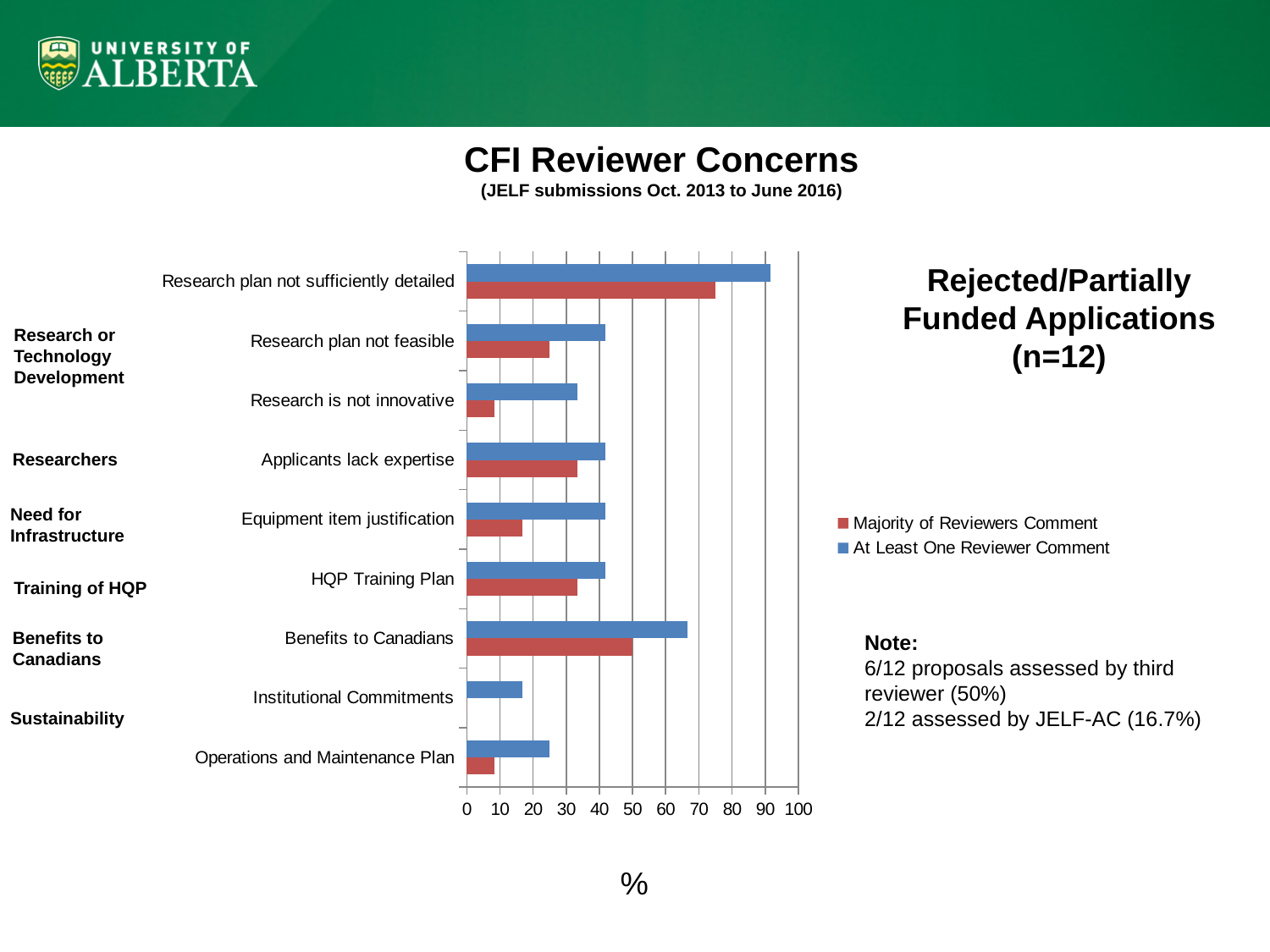
Is the 'At Least One Reviewer Comment' value for 'Research plan not sufficiently detailed' greater or less than 80? greater Which is larger for 'At Least One Reviewer Comment': 'Benefits to Canadians' or 'HQP Training Plan'? Benefits to Canadians Which concern has the lowest value for 'At Least One Reviewer Comment'? Institutional Commitments Is the 'Majority of Reviewers Comment' value for 'Research plan not sufficiently detailed' greater or less than 80? less How many concern categories are plotted on the chart? 9 What kind of chart is shown on the slide? bar chart Is the 'At Least One Reviewer Comment' value for 'Operations and Maintenance Plan' greater or less than 30? less How many series does the chart legend list? 2 Which concern has the highest value for 'At Least One Reviewer Comment'? Research plan not sufficiently detailed Which is larger for 'Majority of Reviewers Comment': 'Applicants lack expertise' or 'Research is not innovative'? Applicants lack expertise What is the title of the chart? CFI Reviewer Concerns